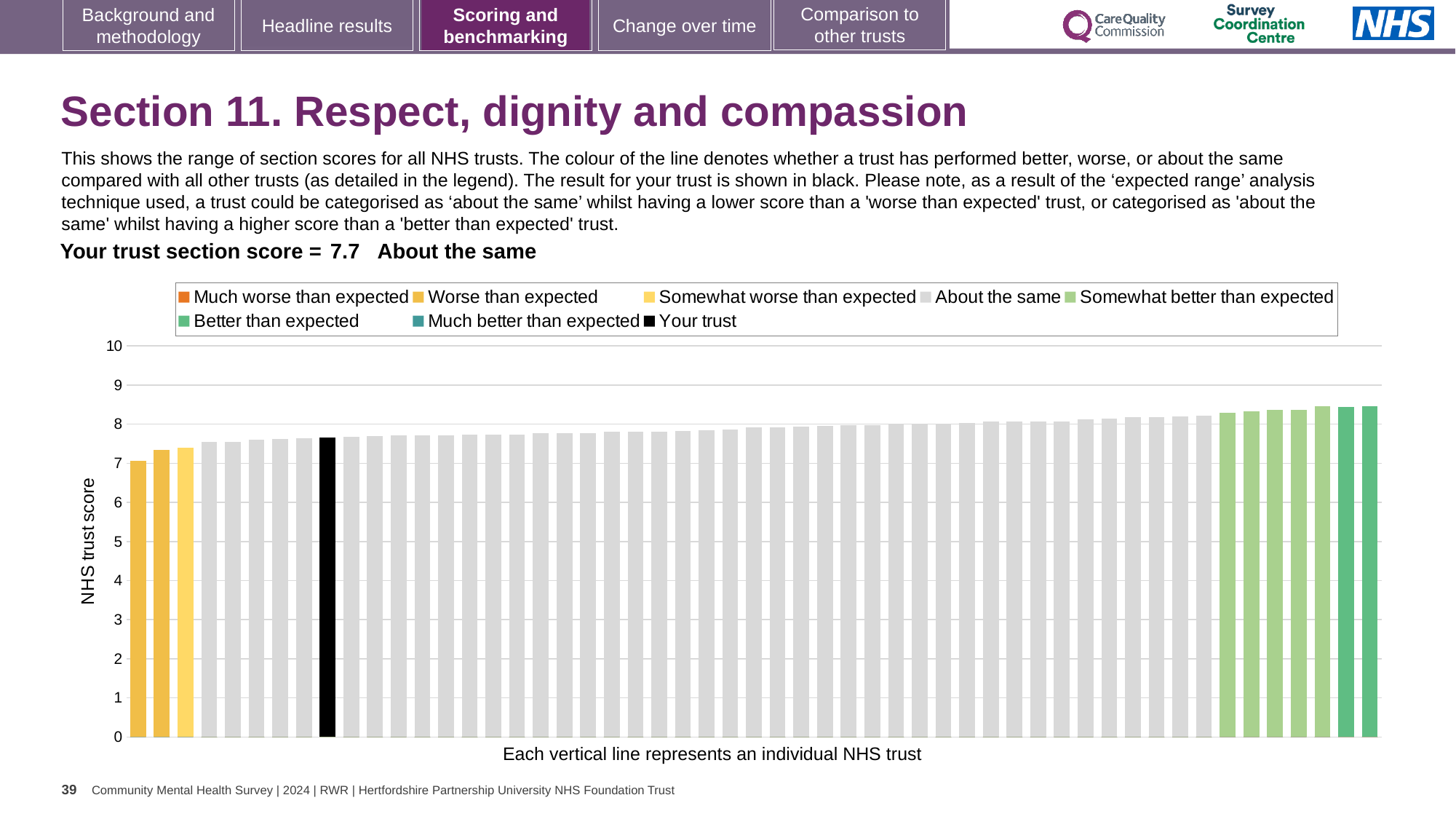
Is the value for your trust greater or less than 5? greater What colour is the bar representing your trust? black Which performance category is your trust placed in for Section 11? About the same What is the section score for your trust shown on the slide? 7.7 Is the value for the lowest-scoring trust greater or less than 8? less How many entries does the chart legend list? 8 Which legend category does the lowest-scoring trust on the far left of the chart belong to? Worse than expected What is the label on the vertical axis of the chart? NHS trust score Is the value for the highest-scoring trust greater or less than 8? greater What kind of chart is shown on the slide? bar chart Which legend category do the highest-scoring trusts on the right of the chart belong to? Better than expected Do the trust scores rise or fall moving from left to right along the x axis? rise